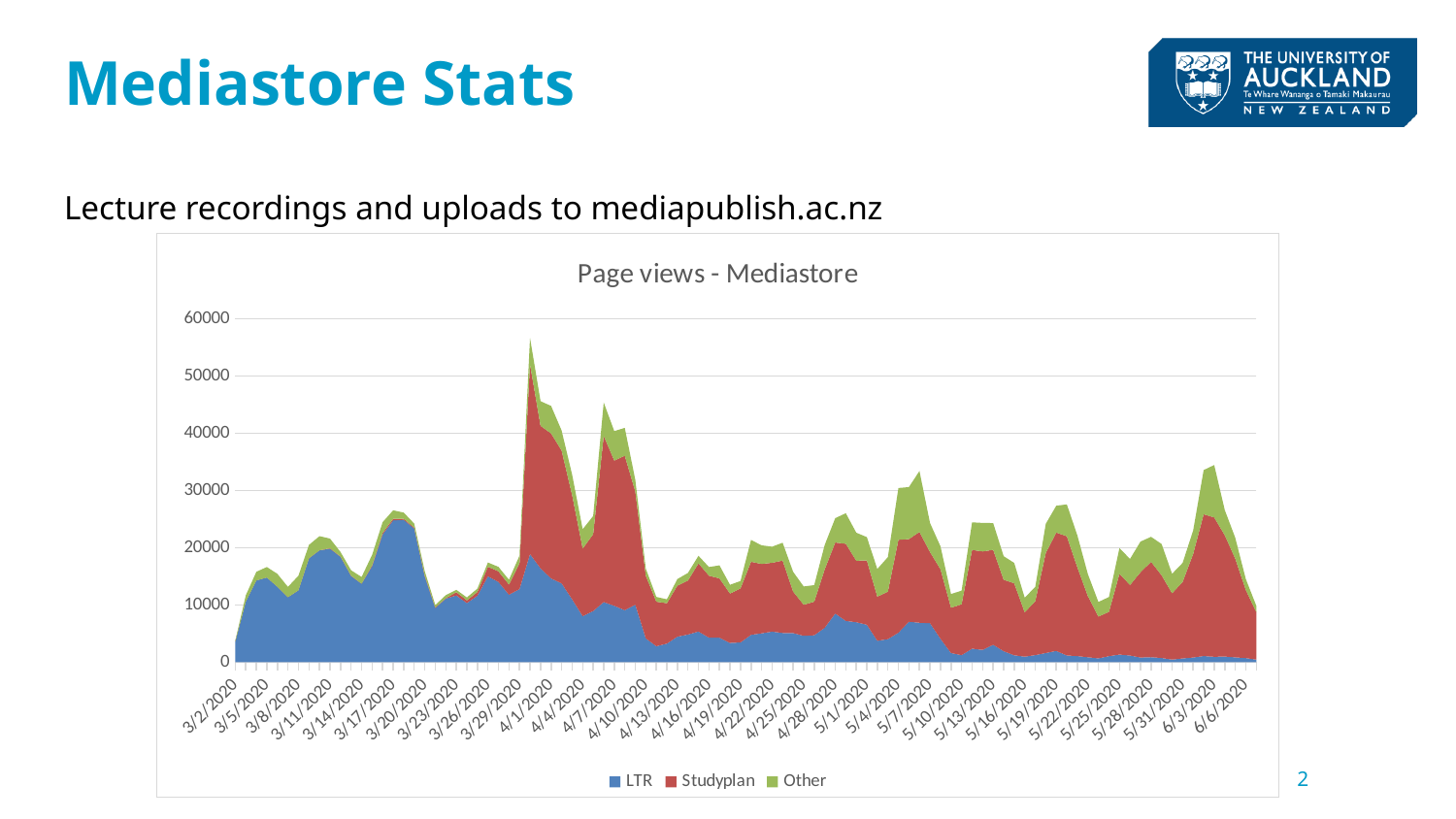
Which series accounts for almost all page views in early March 2020? LTR Which series are listed in the chart's legend? LTR, Studyplan, Other How many series does the chart's legend list? 3 Is the total page views on 3/17/2020 greater or less than 20000? greater What is the title of the chart on the slide? Page views - Mediastore Which series accounts for most of the page views in late May 2020? Studyplan What kind of chart is shown on the slide? Stacked area chart Is the total page views on 4/13/2020 greater or less than 30000? less Does the LTR series rise or fall from March to June 2020? fall Is the highest peak of total page views greater or less than 50000? greater What is the highest value shown on the chart's vertical axis? 60000